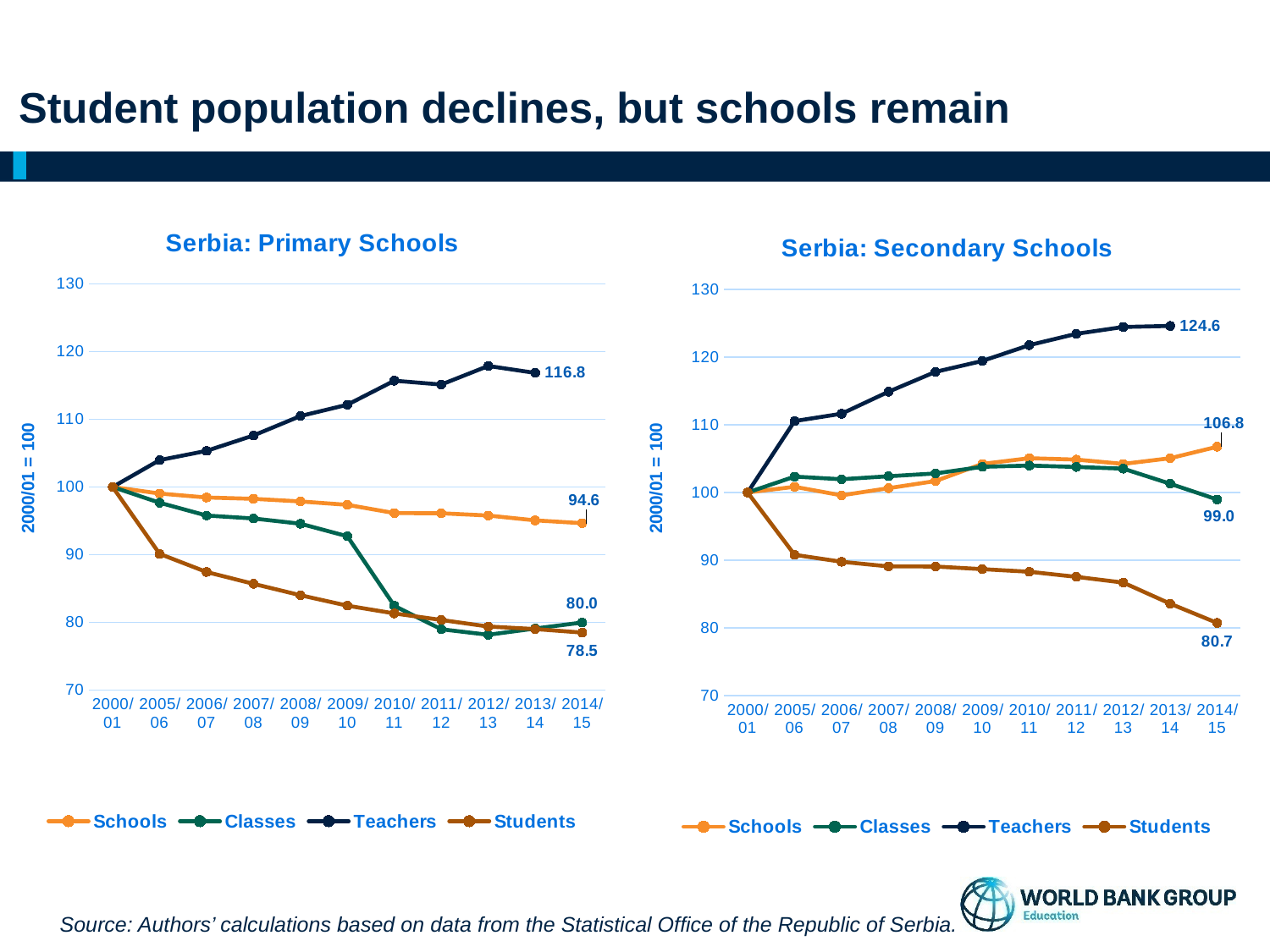
How many series does the legend of the 'Serbia: Secondary Schools' chart list? 4 What kind of chart is 'Serbia: Primary Schools'? Line chart In the 'Serbia: Secondary Schools' chart, what is the value for Schools in 2014/15? 106.8 In the 'Serbia: Secondary Schools' chart, does the Teachers series rise or fall from 2000/01 to 2014/15? Rise In the 'Serbia: Secondary Schools' chart, which series has the highest value in 2014/15? Schools In the 'Serbia: Primary Schools' chart, what is the value for Students in 2014/15? 78.5 In the 'Serbia: Secondary Schools' chart, what is the value for Classes in 2014/15? 99.0 In the 'Serbia: Primary Schools' chart, which is larger in 2014/15: Schools or Classes? Schools In the 'Serbia: Primary Schools' chart, which series has the lowest value in 2014/15? Students In the 'Serbia: Primary Schools' chart, is the value for Students in 2005/06 greater or less than 100? less